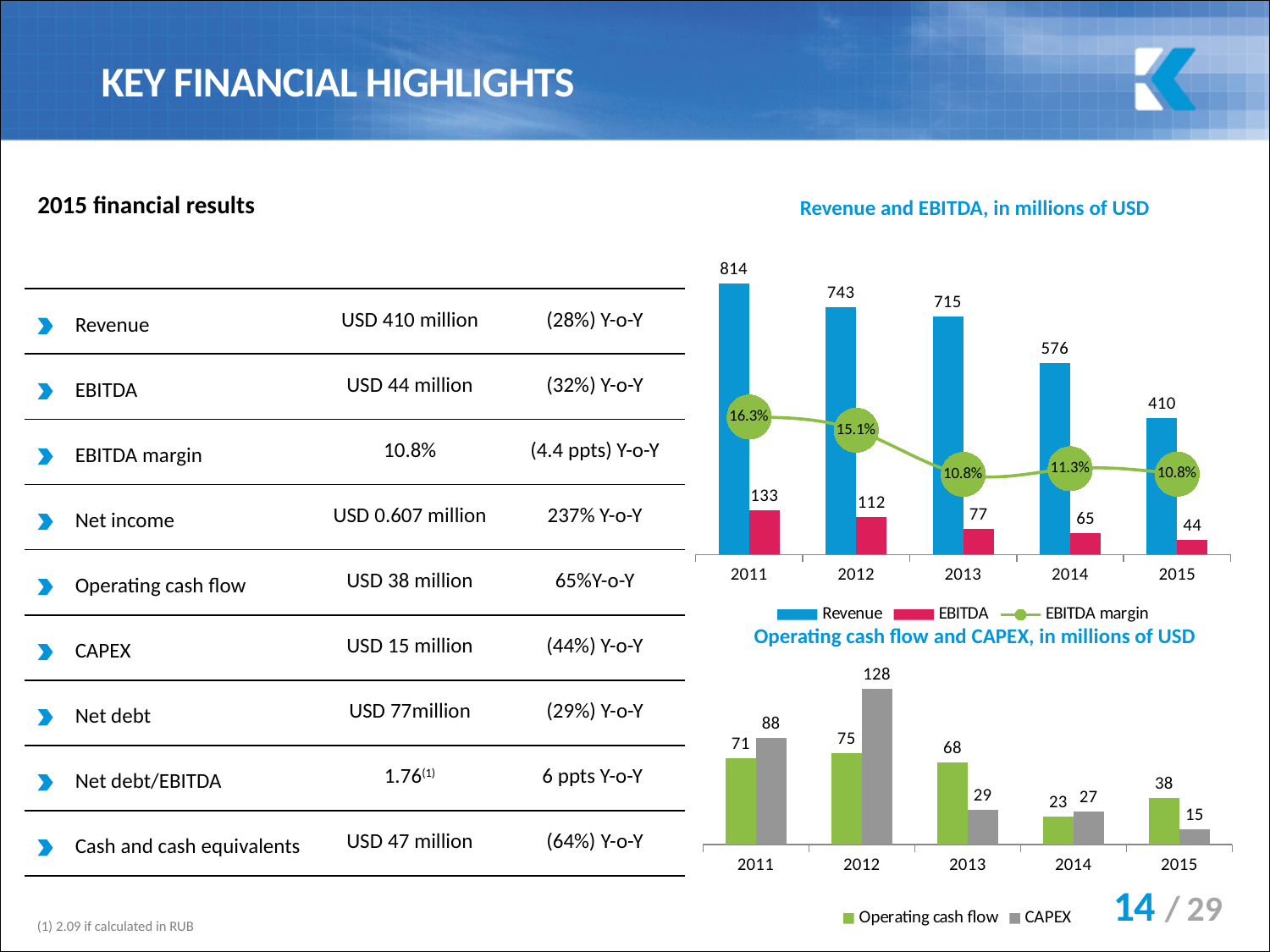
In the 'Operating cash flow and CAPEX, in millions of USD' chart, how many years are shown on the x axis? 5 In the 'Revenue and EBITDA, in millions of USD' chart, what is the EBITDA value for 2013? 77 In the 'Revenue and EBITDA, in millions of USD' chart, what is the Revenue value for 2011? 814 What kind of chart is the 'Operating cash flow and CAPEX, in millions of USD' chart? bar chart In the 'Revenue and EBITDA, in millions of USD' chart, what is the EBITDA margin for 2012? 15.1% In the 'Operating cash flow and CAPEX, in millions of USD' chart, which is larger in 2015: Operating cash flow or CAPEX? Operating cash flow In the 'Revenue and EBITDA, in millions of USD' chart, which year has the lowest Revenue? 2015 In the 'Revenue and EBITDA, in millions of USD' chart, how many series does the legend list? 3 In the 'Operating cash flow and CAPEX, in millions of USD' chart, which year has the highest Operating cash flow? 2012 In the 'Operating cash flow and CAPEX, in millions of USD' chart, what is the CAPEX value for 2012? 128 In the 'Revenue and EBITDA, in millions of USD' chart, does Revenue rise or fall from 2011 to 2015? fall In the 'Revenue and EBITDA, in millions of USD' chart, what is the difference between Revenue in 2011 and Revenue in 2015? 404